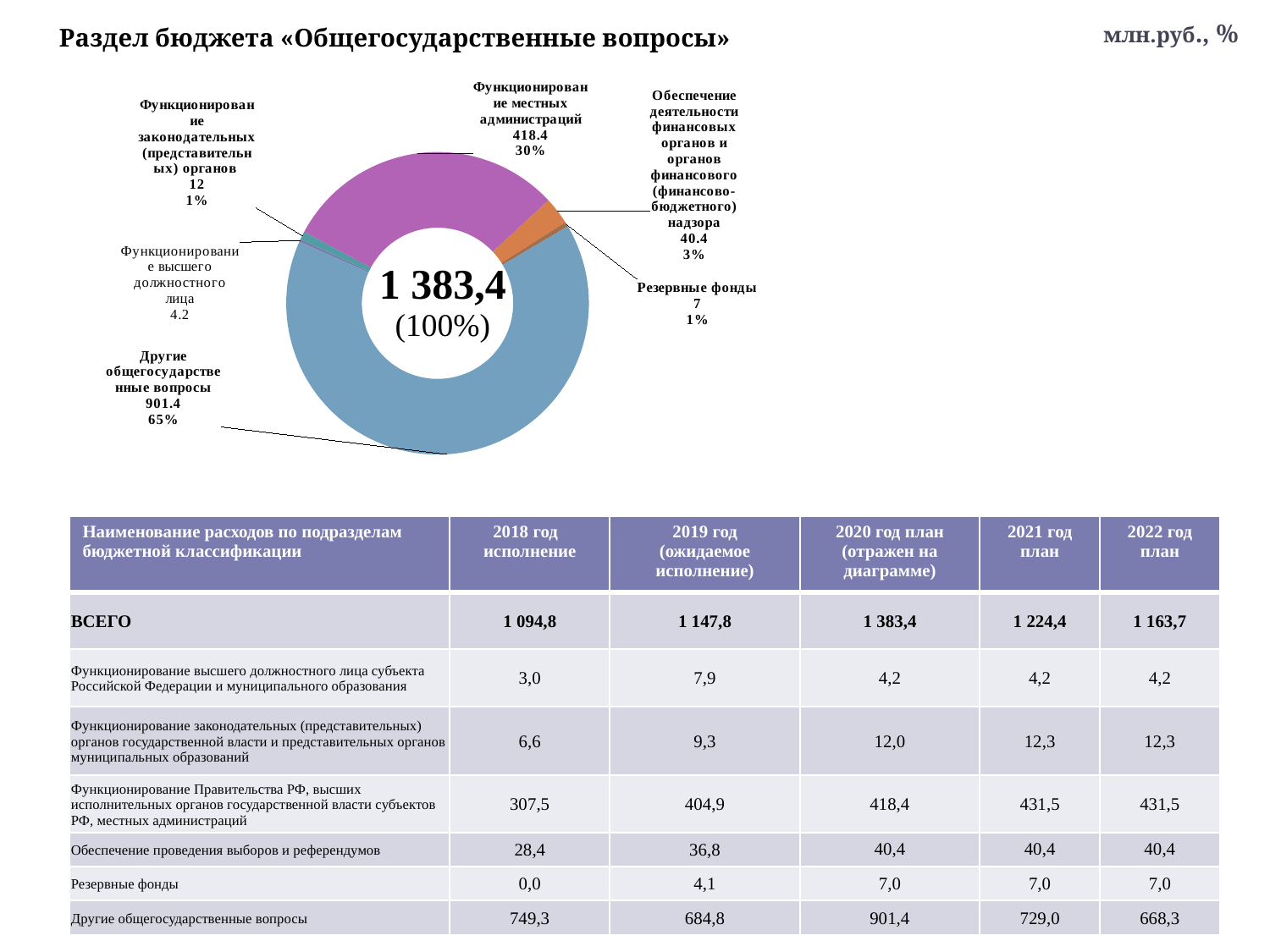
What value is labelled for «Функционирование высшего должностного лица»? 4.2 What value is shown in the centre of the doughnut chart? 1 383,4 (100%) What percentage share is labelled for «Функционирование местных администраций»? 30% Which slice of the doughnut chart is the smallest? Функционирование высшего должностного лица What value is labelled for «Резервные фонды»? 7 What is the difference between the values for «Другие общегосударственные вопросы» and «Функционирование местных администраций»? 483 What value is labelled for «Обеспечение деятельности финансовых органов и органов финансового (финансово-бюджетного) надзора»? 40.4 How many slices does the doughnut chart have? 6 What kind of chart is shown on the slide? Doughnut (pie) chart Which is larger: «Функционирование законодательных (представительных) органов» or «Резервные фонды»? Функционирование законодательных (представительных) органов What value is labelled for the slice «Другие общегосударственные вопросы»? 901.4 Which slice of the doughnut chart is the largest? Другие общегосударственные вопросы